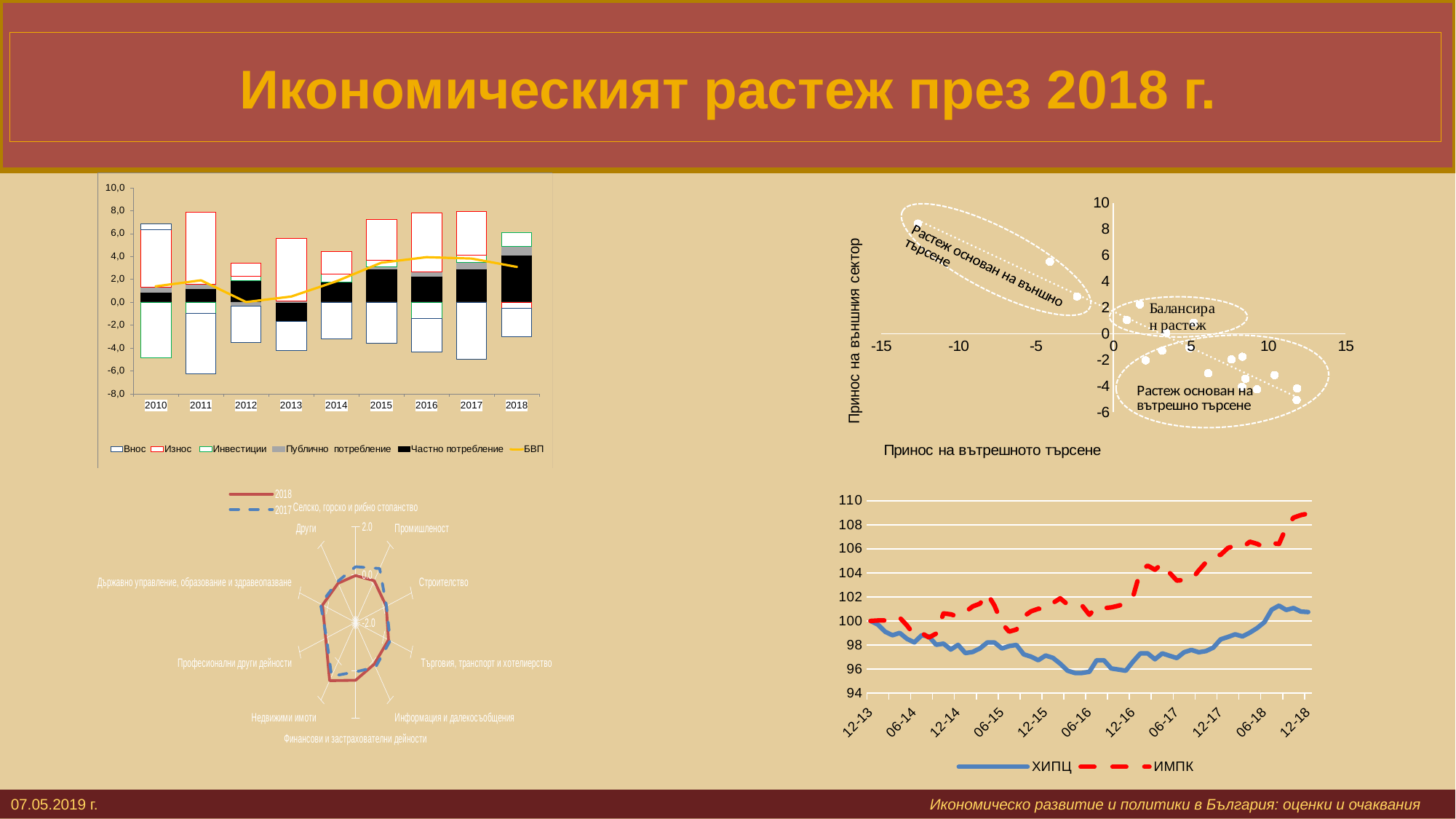
In the bottom-right chart, how many series does the legend list? 2 In the top-left chart, how many years are shown on the x axis? 9 In the top-left chart, is the value of the БВП line for 2018 greater or less than 2,0? greater In the bottom-left radar chart, how many series does the legend list? 2 In the bottom-right chart, is the value of ХИПЦ at 06-16 greater or less than 98? less In the top-left chart, is the value of the БВП line for 2012 greater or less than 2,0? less In the bottom-right chart, does the ИМПК series rise or fall overall from 12-13 to 12-18? rise In the top-left chart, which series is drawn as a line rather than bars? БВП In the top-left chart, how many series does the legend list? 6 What kind of chart is the top-left chart? Bar chart with a line In the bottom-right chart, which series is higher at 12-18, ХИПЦ or ИМПК? ИМПК